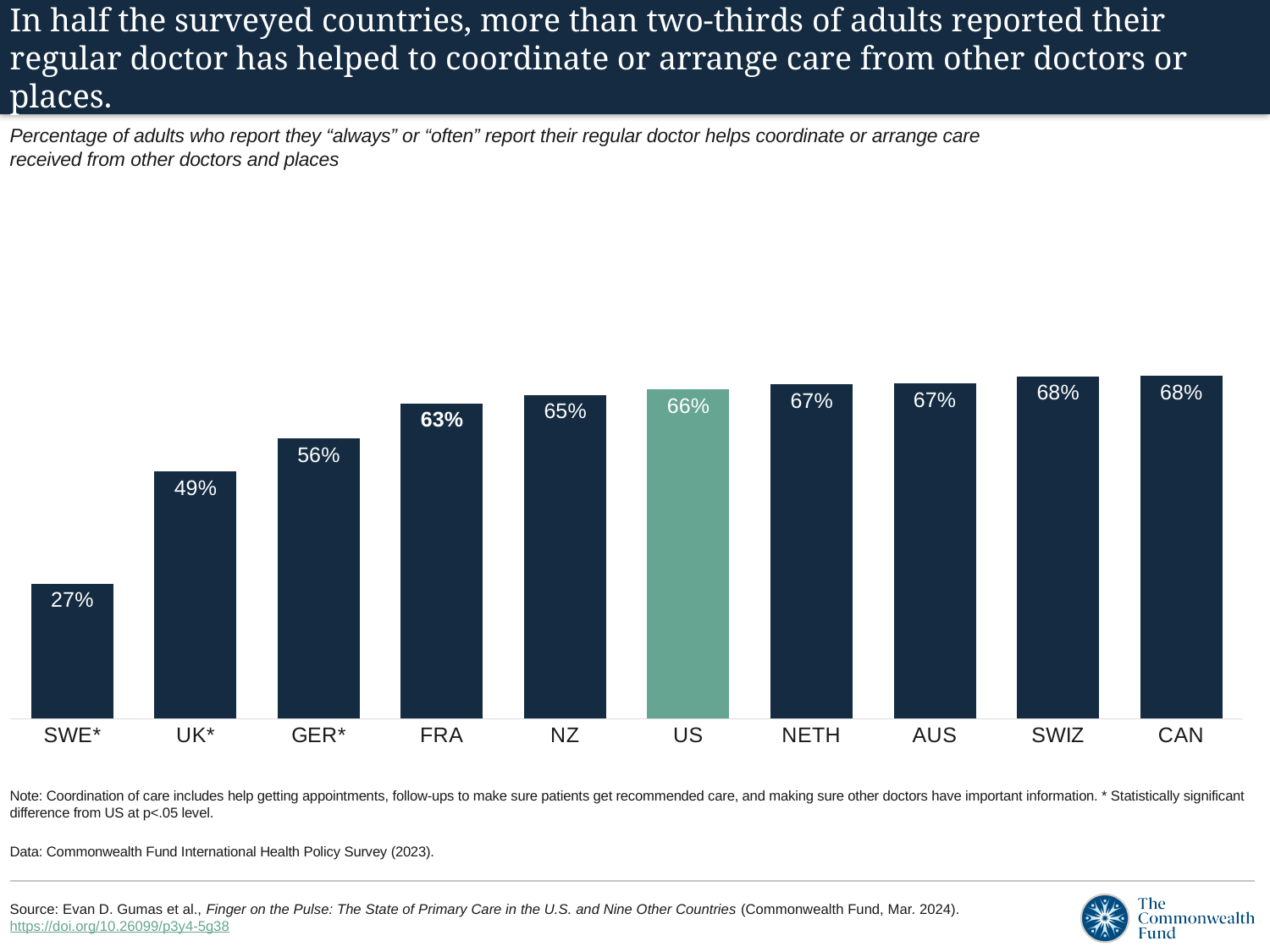
What kind of chart is shown on the slide? Bar chart What is the value for the US? 66% Which is larger, the value for UK* or the value for GER*? GER* What is the value for SWE*? 27% What is the difference between the values for CAN and SWE*? 41% Which country has the lowest value? SWE* How many countries are shown in the chart? 10 What is the difference between the values for US and UK*? 17% Which is larger, the value for FRA or the value for NZ? NZ Do the values rise or fall from left to right across the x axis? Rise What is the value for GER*? 56% Which country's bar is shown in a different colour (green) from the others? US